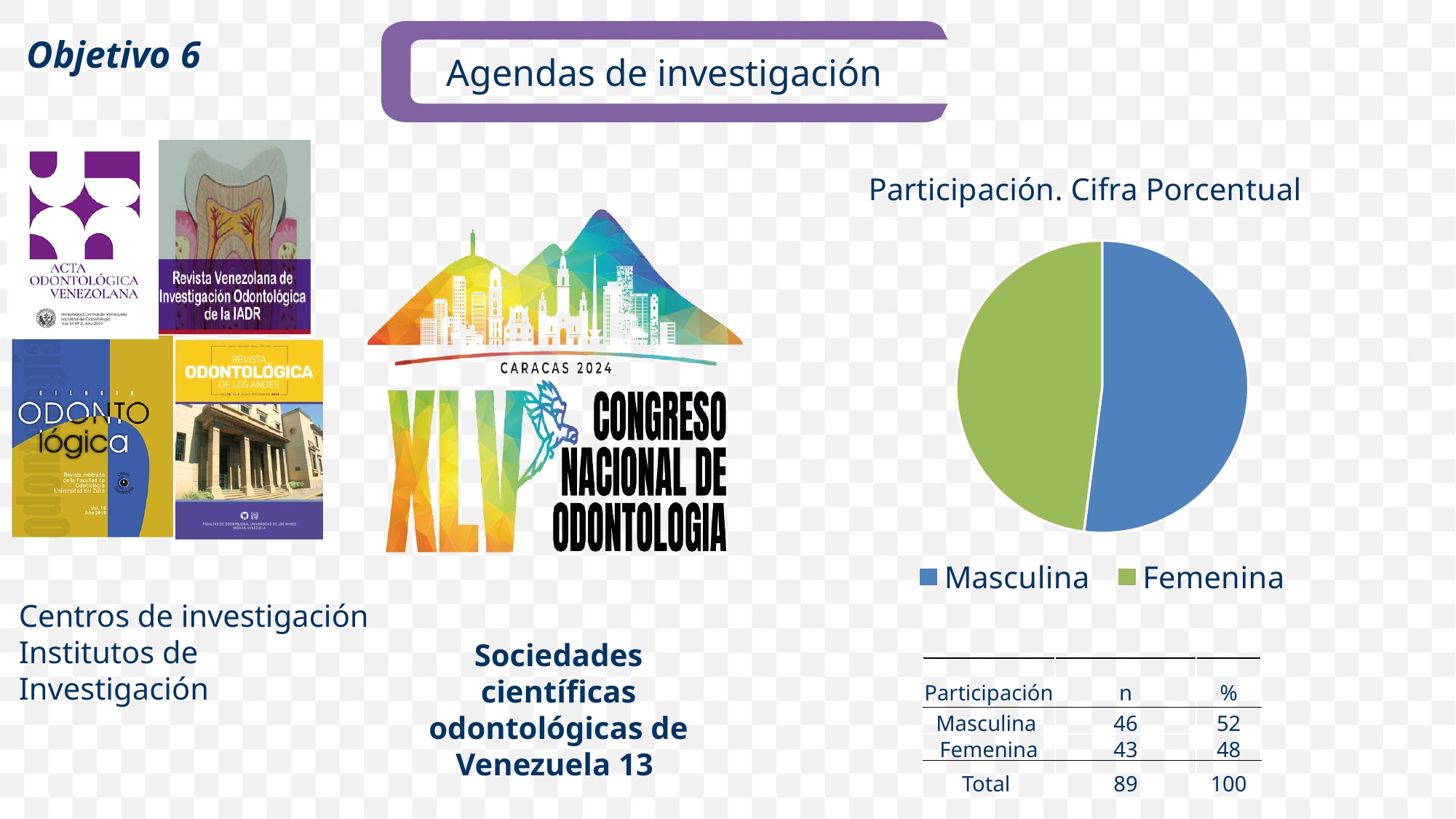
Which colour represents Masculina in the pie chart? blue How many entries does the legend of the pie chart list? 2 Which category has the smallest slice in the pie chart? Femenina How many slices does the pie chart have? 2 According to the table below the pie chart, what percentage share does Masculina have? 52% Which slice is larger in the pie chart, Masculina or Femenina? Masculina Which category has the largest slice in the pie chart? Masculina According to the table below the pie chart, what percentage share does Femenina have? 48% What kind of chart is shown under the title "Participación. Cifra Porcentual"? pie chart According to the table below the pie chart, what is the total n? 89 According to the table below the pie chart, what is the n value for Femenina? 43 What is the title of the pie chart? Participación. Cifra Porcentual